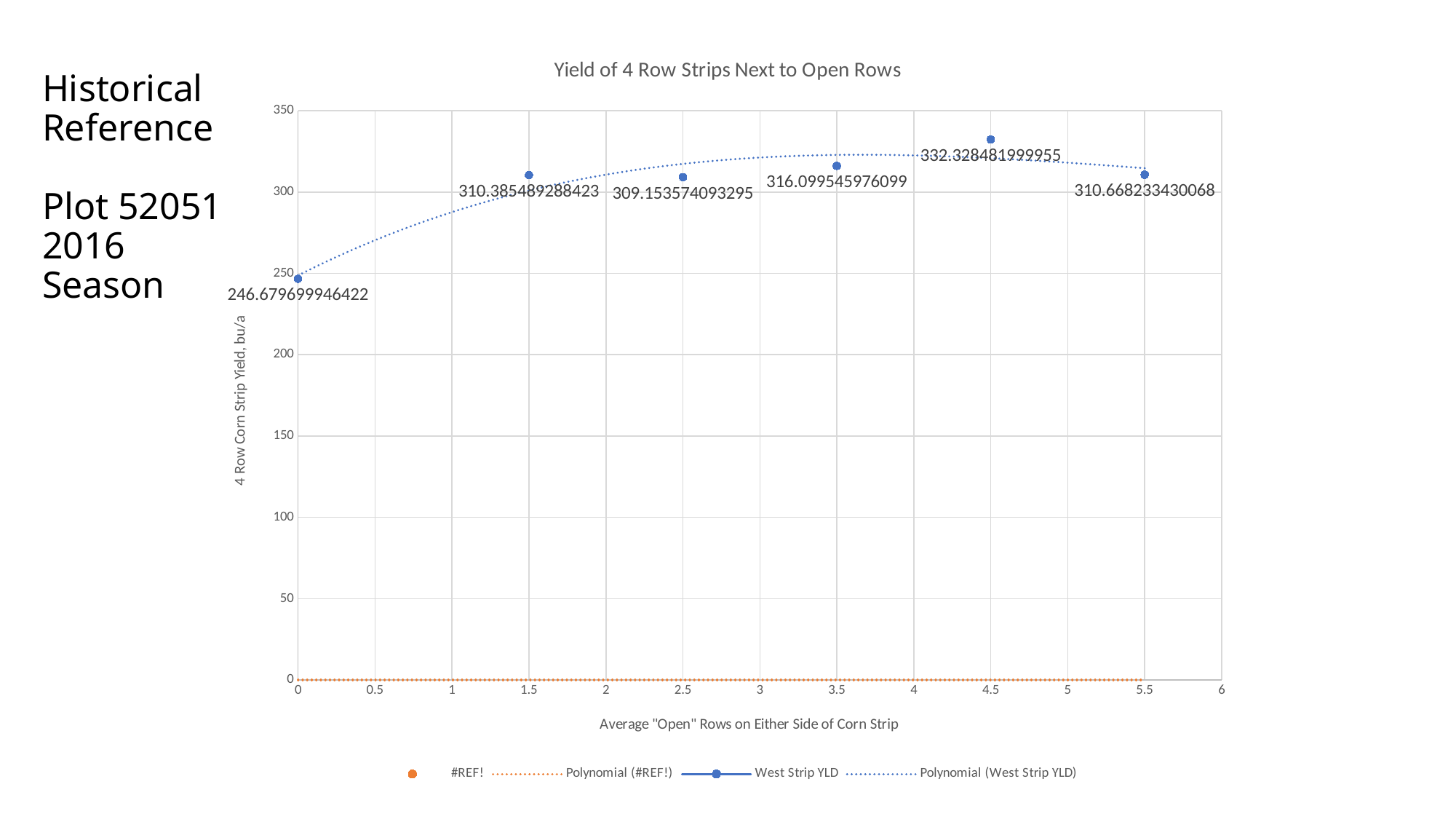
How many entries does the legend list? 4 What is the title of the chart? Yield of 4 Row Strips Next to Open Rows What type of chart is shown on the slide? scatter chart What is the West Strip YLD value at 5.5 average open rows? 310.668233430068 What is the West Strip YLD value at 2.5 average open rows? 309.153574093295 What is the West Strip YLD value at 0 average open rows? 246.679699946422 What is the West Strip YLD value at 4.5 average open rows? 332.328481999955 At which x value is the West Strip YLD lowest? 0 Is the West Strip YLD value at 0 average open rows greater or less than 250? less Which is larger, the West Strip YLD at 3.5 or at 1.5? 3.5 At which x value is the West Strip YLD highest? 4.5 How many West Strip YLD data points are plotted? 6